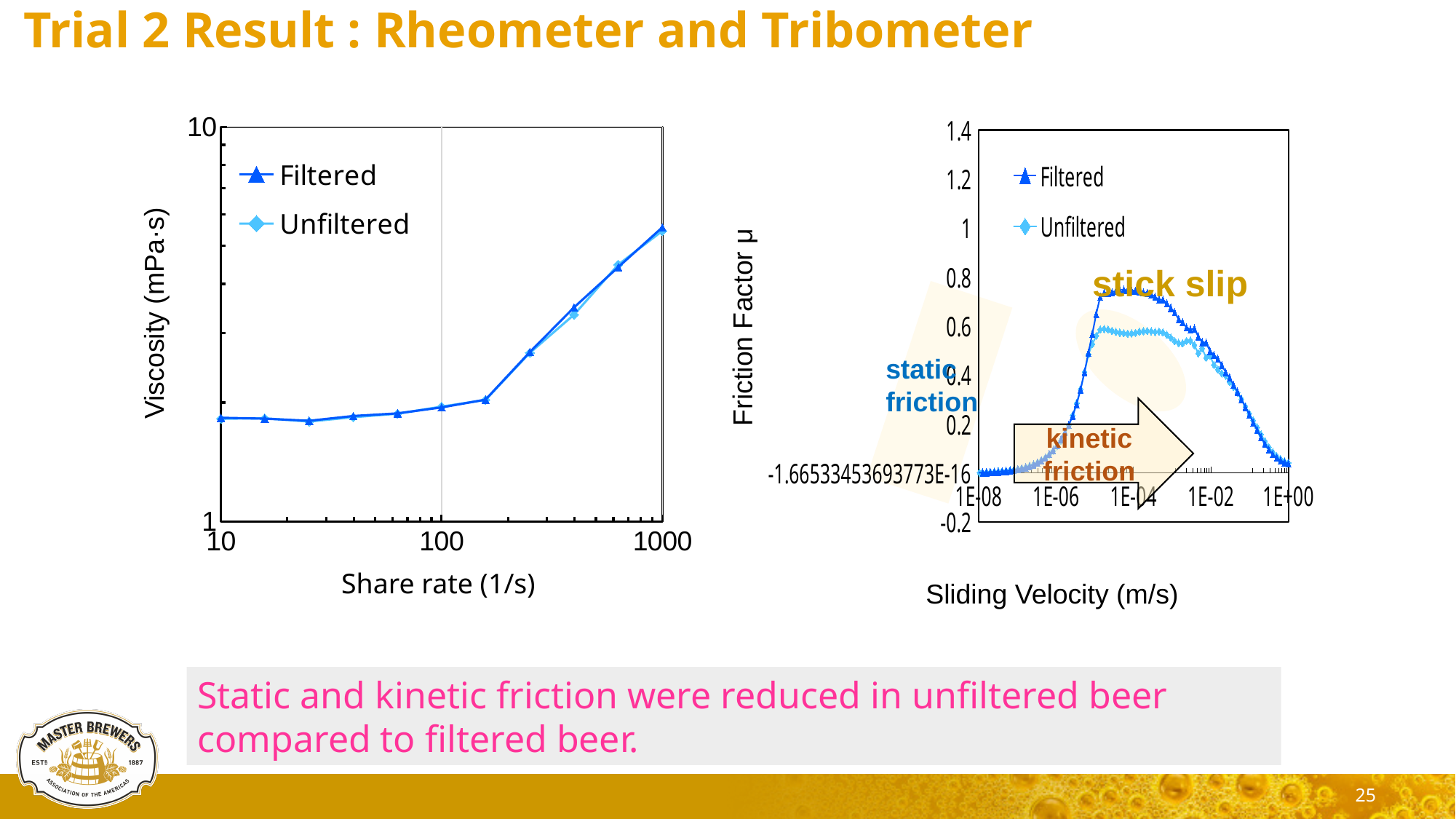
In the right chart (Friction Factor vs Sliding Velocity), is the peak friction factor of the Unfiltered series greater or less than 0.8? less What is the x-axis title of the right chart (Friction Factor chart)? Sliding Velocity (m/s) In the right chart (Friction Factor vs Sliding Velocity), is the peak friction factor of the Filtered series greater or less than 0.6? greater In the left chart (Viscosity vs Share rate), what are the two series named in the legend? Filtered and Unfiltered In the left chart (Viscosity vs Share rate), is the Filtered viscosity at a share rate of 10 1/s greater or less than 10 mPa·s? less In the left chart (Viscosity vs Share rate), is the Filtered viscosity larger at a share rate of 10 1/s or at 1000 1/s? 1000 1/s How many series does the legend of the right chart (Friction Factor vs Sliding Velocity) list? 2 In the left chart (Viscosity vs Share rate), does the viscosity rise or fall as the share rate increases from 100 to 1000 1/s? rise What kind of chart is the left chart (Viscosity vs Share rate)? line chart How many series does the legend of the left chart (Viscosity vs Share rate) list? 2 In the right chart (Friction Factor vs Sliding Velocity), which series reaches the higher peak friction factor? Filtered